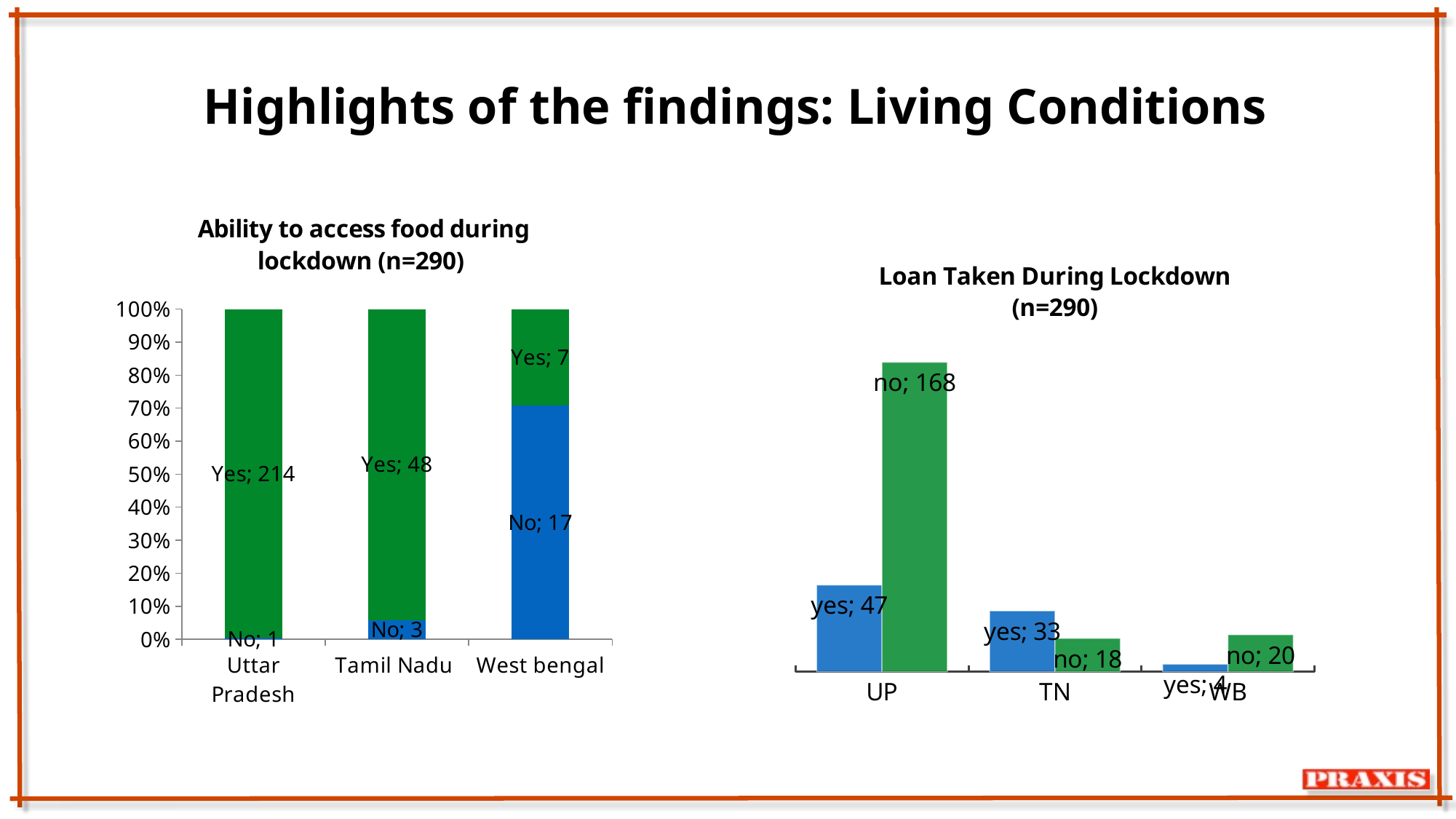
In the 'Ability to access food during lockdown' chart, how many respondents from Tamil Nadu answered No? 3 In the 'Loan Taken During Lockdown' chart, how many respondents from UP answered no? 168 In the 'Ability to access food during lockdown' chart, which state has the largest number of Yes responses? Uttar Pradesh In the 'Ability to access food during lockdown' chart, how many respondents from Uttar Pradesh answered Yes? 214 In the 'Loan Taken During Lockdown' chart, which state has the lowest yes count? WB In the 'Loan Taken During Lockdown' chart, what is the difference between the yes and no counts for TN? 15 In the 'Loan Taken During Lockdown' chart, how many respondents from WB answered yes? 4 In the 'Ability to access food during lockdown' chart, how many states are shown on the x axis? 3 In the 'Loan Taken During Lockdown' chart, which is larger for UP: the yes count or the no count? no What kind of chart is 'Ability to access food during lockdown'? Stacked bar chart In the 'Ability to access food during lockdown' chart, how many respondents from West bengal answered No? 17 In the 'Ability to access food during lockdown' chart, what is the total number of respondents for West bengal (Yes plus No)? 24